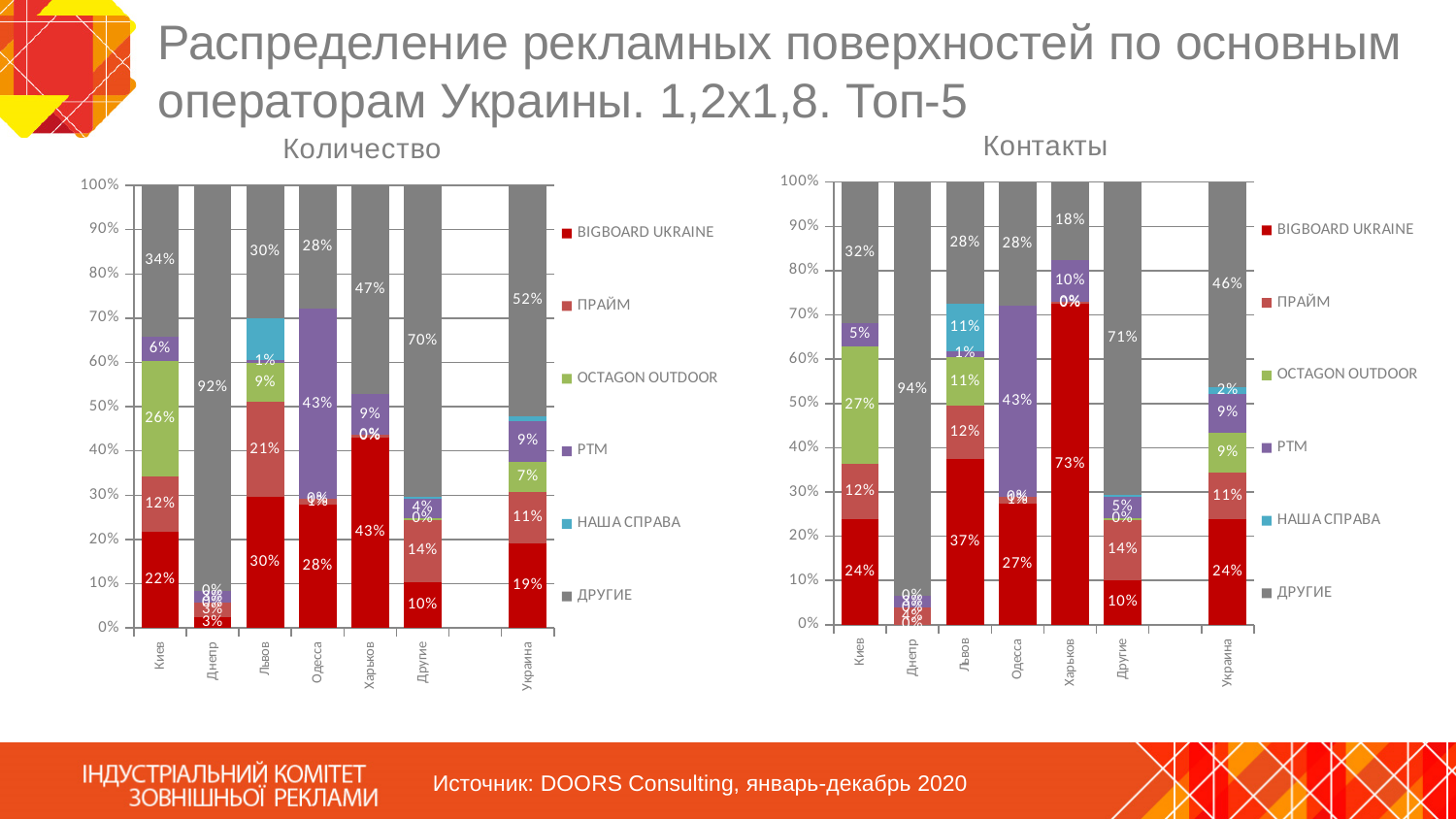
In the Контакты chart, what share does BIGBOARD UKRAINE have in Харьков? 73% In the Количество chart, what share does ДРУГИЕ have in Днепр? 92% In the Количество chart, what share does BIGBOARD UKRAINE have in Киев? 22% In the Контакты chart, what share does ДРУГИЕ have in Украина? 46% In the Контакты chart, what share does OCTAGON OUTDOOR have in Киев? 27% In the Количество chart, which category has the highest share for BIGBOARD UKRAINE? Харьков In the Контакты chart, which category has the highest share for ДРУГИЕ? Днепр In the Количество chart, what is the difference between the ДРУГИЕ share in Другие and in Украина? 18% In the Контакты chart, which is larger: the РТМ share in Одесса or in Украина? Одесса How many categories are shown on the x axis of the Количество chart? 7 How many series does the legend of the Контакты chart list? 6 What type of chart is the Количество chart? Stacked bar chart